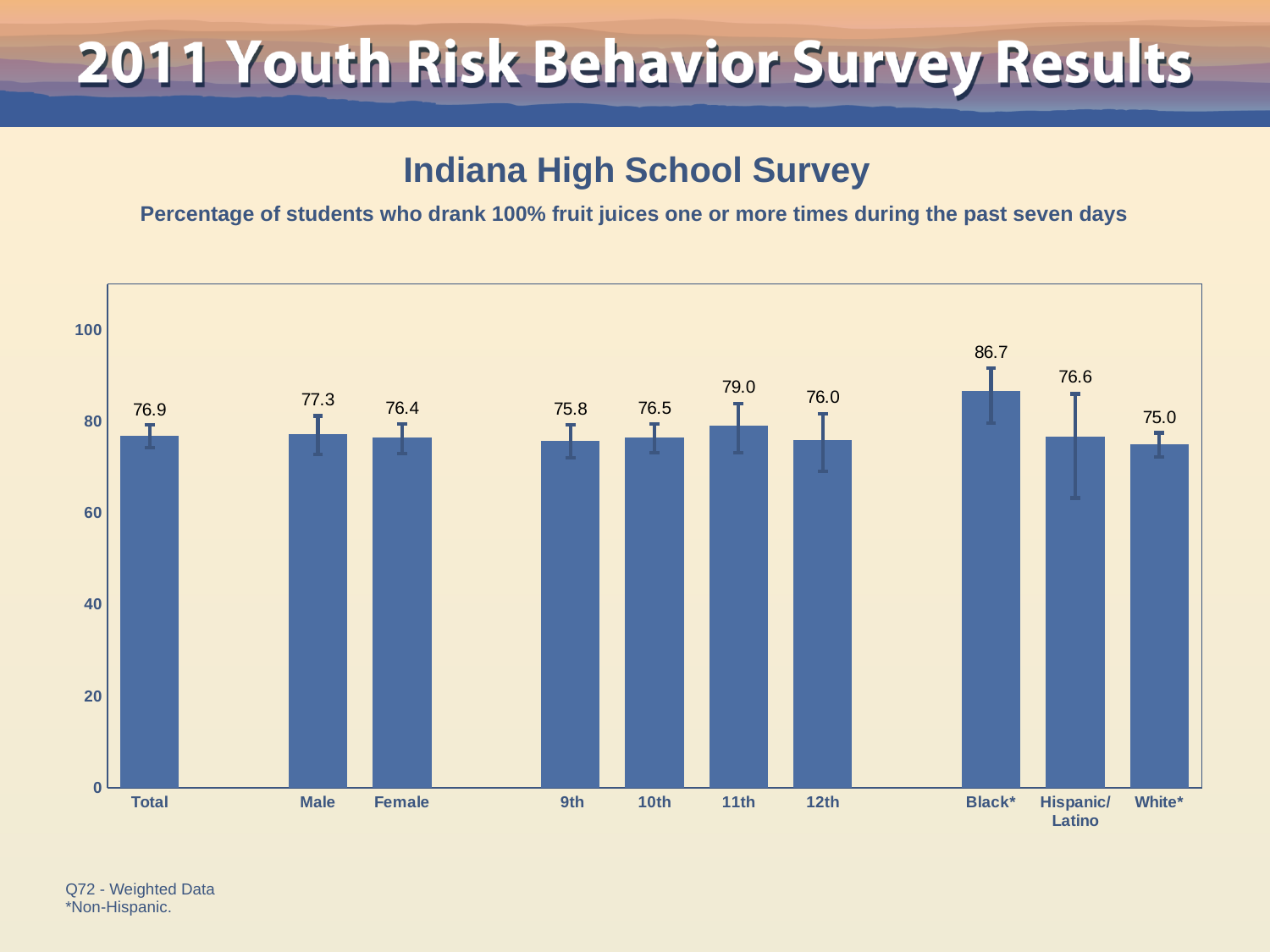
What is the difference between the values for Black* and White*? 11.7 Which is larger, the value for 11th or the value for 9th? 11th Which category has the lowest value? White* What is the value for Black*? 86.7 What is the difference between the values for Male and Female? 0.9 How many categories are shown on the chart? 10 Which category has the highest value? Black* What kind of chart is shown on the slide? Bar chart What is the subtitle describing what the chart measures? Percentage of students who drank 100% fruit juices one or more times during the past seven days What is the value for Total? 76.9 What is the value for Hispanic/Latino? 76.6 What is the value for 11th? 79.0